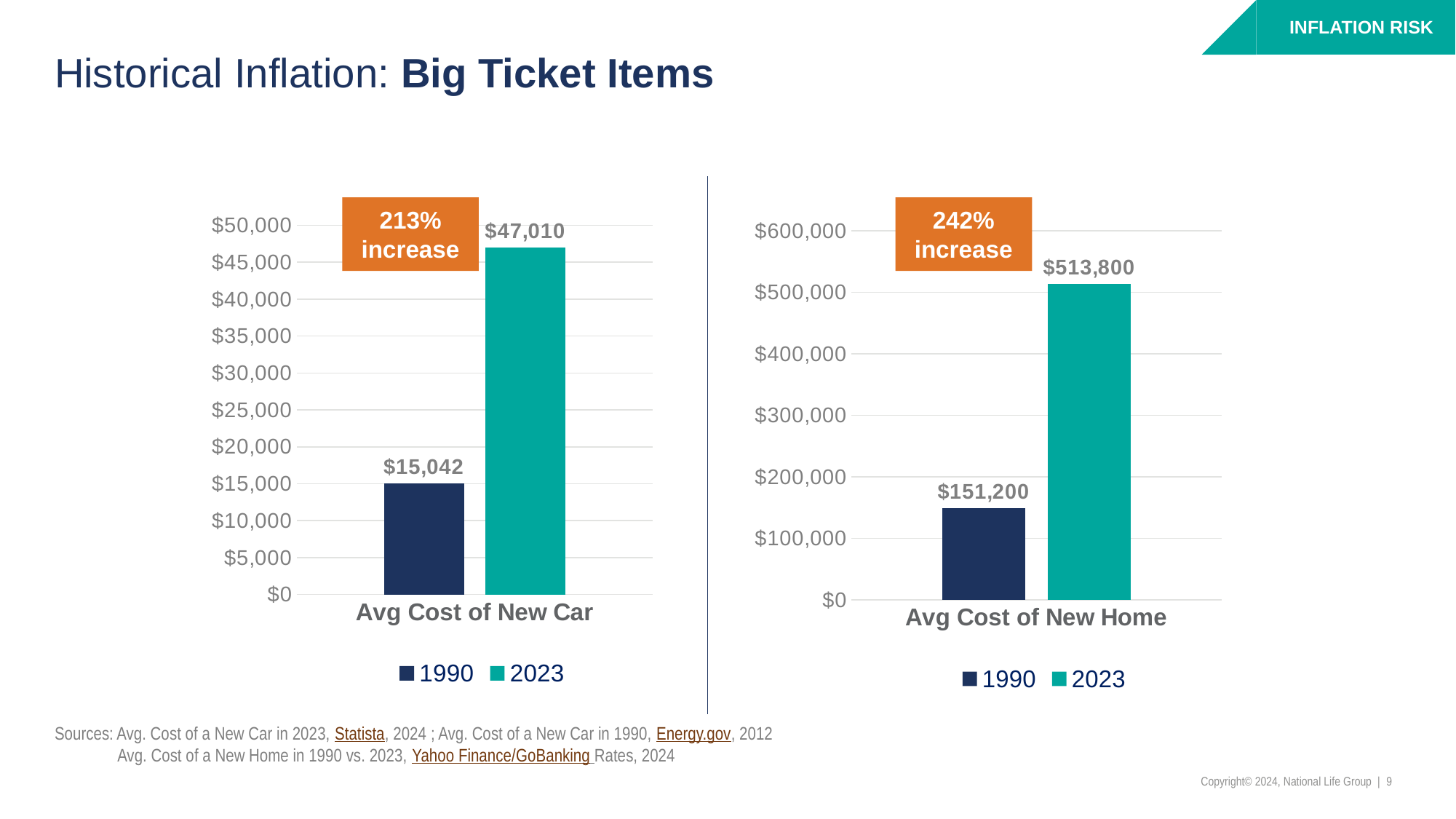
In the Avg Cost of New Home chart, which series has the smaller value, 1990 or 2023? 1990 In the Avg Cost of New Car chart, what is the value for 1990? $15,042 In the Avg Cost of New Home chart, what percentage increase is shown in the orange label? 242% increase In the Avg Cost of New Car chart, what is the difference between the 2023 and 1990 values? $31,968 In the Avg Cost of New Home chart, what is the value for 2023? $513,800 In the Avg Cost of New Home chart, what is the difference between the 2023 and 1990 values? $362,600 What kind of chart is the Avg Cost of New Car chart? Bar chart In the Avg Cost of New Home chart, what is the value for 1990? $151,200 How many series does the legend list in the Avg Cost of New Home chart? 2 In the Avg Cost of New Car chart, what is the value for 2023? $47,010 In the Avg Cost of New Car chart, what percentage increase is shown in the orange label? 213% increase In the Avg Cost of New Car chart, which series has the larger value, 1990 or 2023? 2023